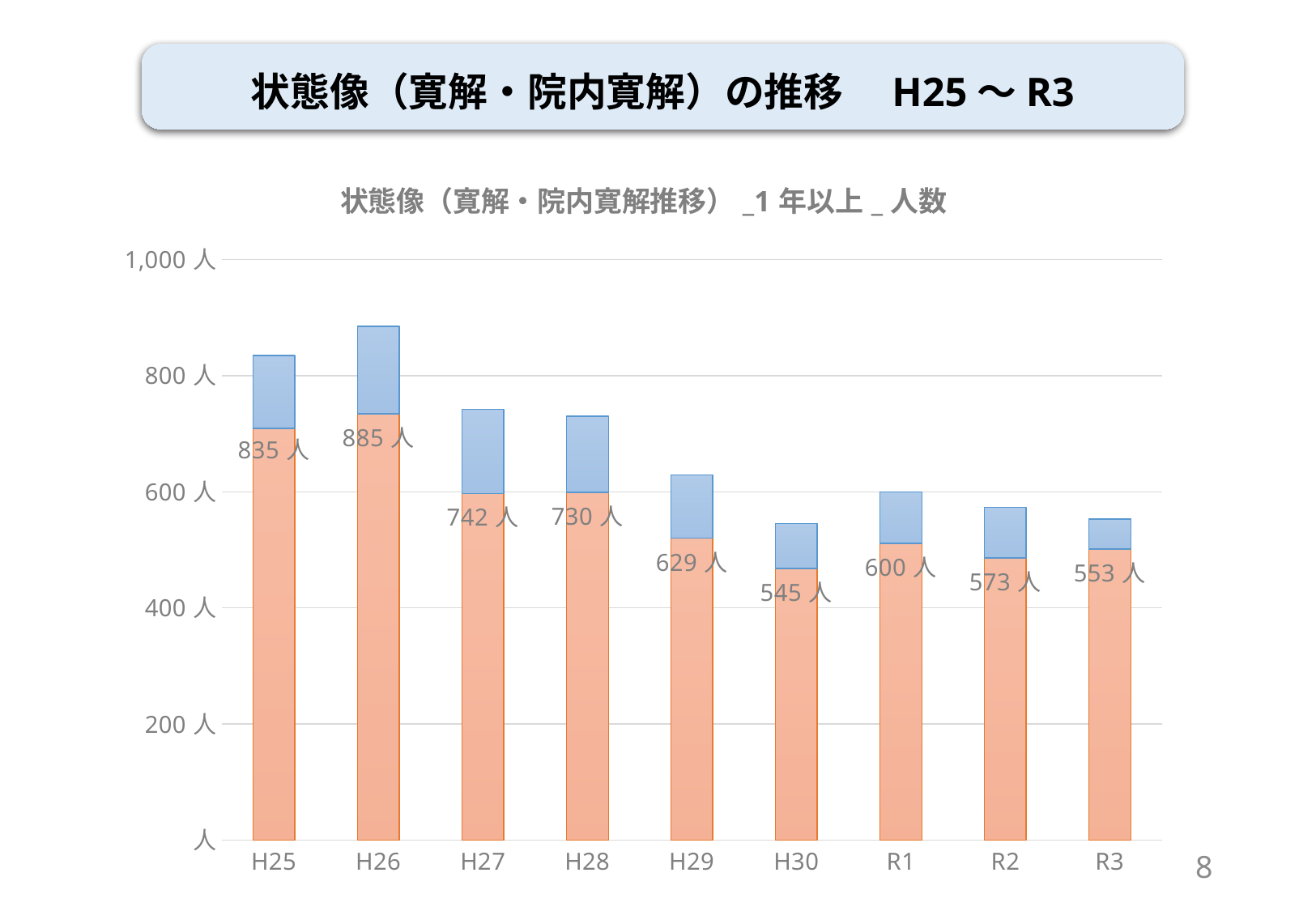
What is the labelled value for H25? 835 人 Which year has the highest labelled value? H26 Is the orange segment of the H25 bar greater or less than 600 人? greater What is the difference between the labelled values for H26 and H25? 50 人 What is the labelled value for R3? 553 人 How many years are shown on the x axis? 9 What is the difference between the labelled values for R1 and R2? 27 人 What kind of chart is shown on the slide? Stacked bar chart What is the labelled value for H29? 629 人 Which is larger, the labelled value for H27 or for H28? H27 Which year has the lowest labelled value? H30 Do the labelled values generally rise or fall from H26 to R3? Fall